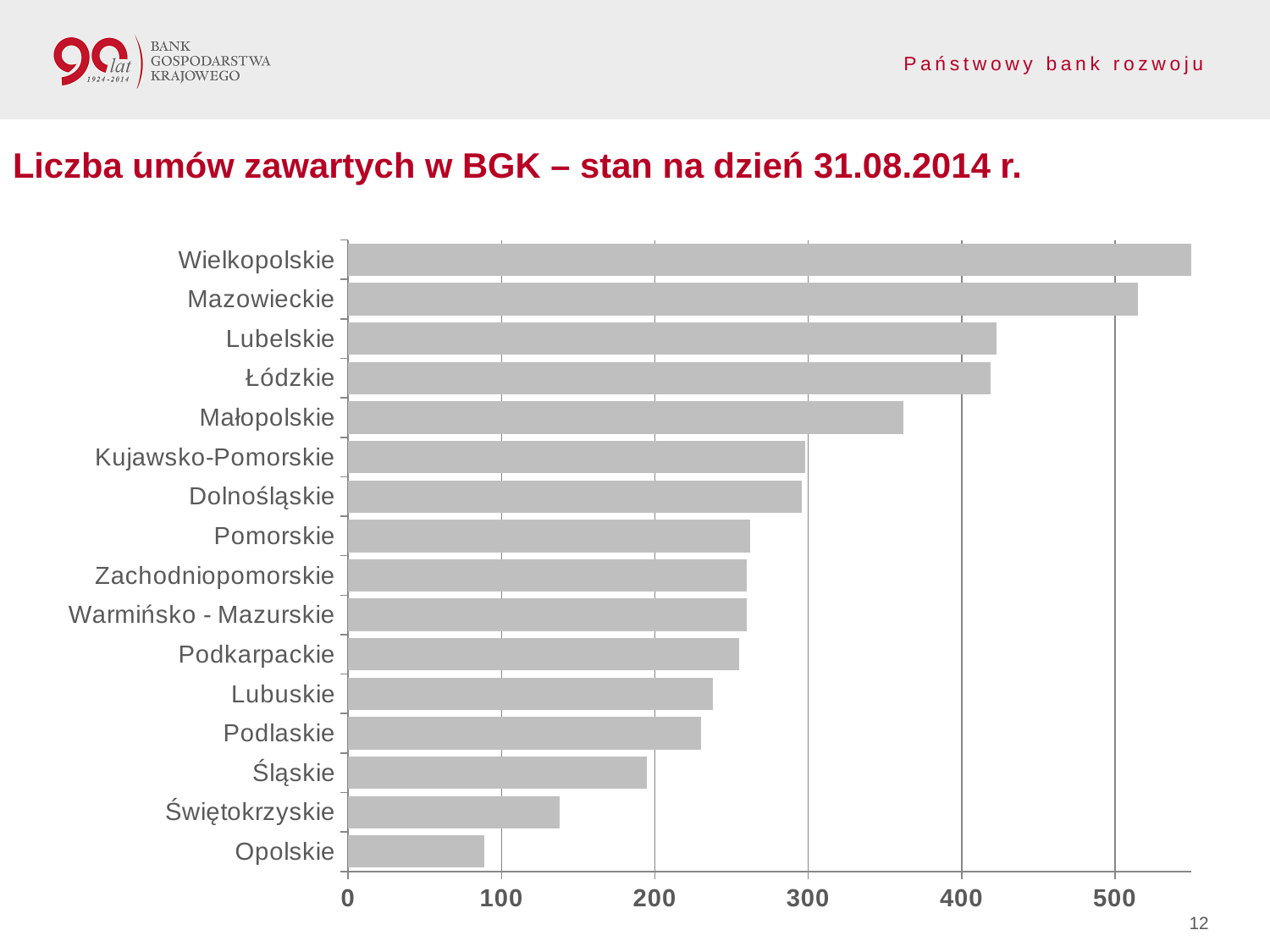
What is the title of the chart on the slide? Liczba umów zawartych w BGK – stan na dzień 31.08.2014 r. What kind of chart is shown on the slide? bar chart Which category has the lowest number of agreements? Opolskie Is the value for Opolskie greater or less than 100? less Which category has the highest number of agreements? Wielkopolskie Is the value for Lubelskie greater or less than 400? greater Which has more agreements, Wielkopolskie or Mazowieckie? Wielkopolskie Is the value for Wielkopolskie greater or less than 500? greater Which has more agreements, Małopolskie or Pomorskie? Małopolskie How many voivodeships (categories) are shown in the chart? 16